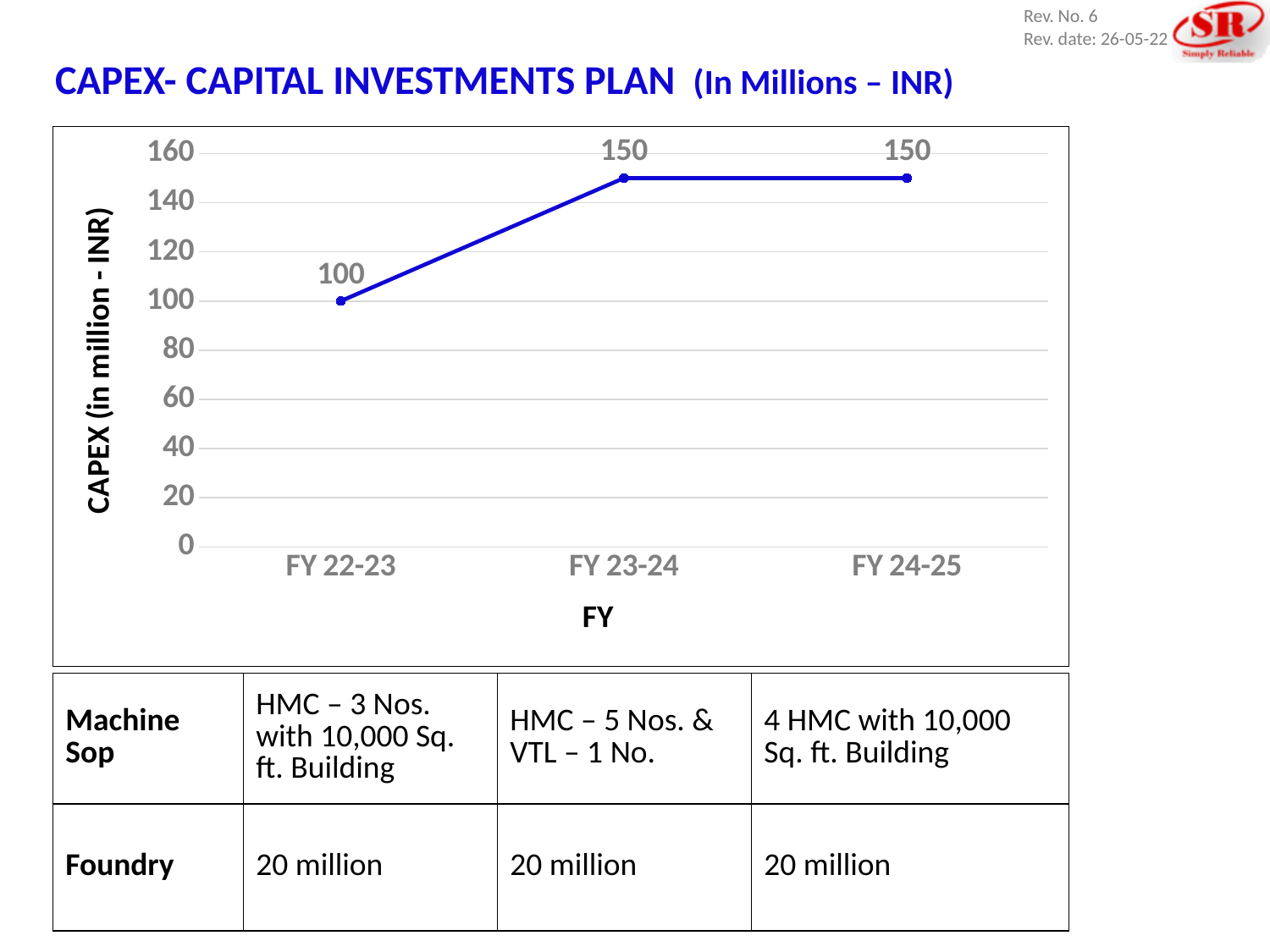
What is the CAPEX value for FY 22-23? 100 Which fiscal year has the lowest CAPEX value? FY 22-23 Does the CAPEX value rise or fall from FY 22-23 to FY 23-24? rise Which is larger, the CAPEX value for FY 22-23 or for FY 23-24? FY 23-24 What is the CAPEX value for FY 23-24? 150 What is the difference between the CAPEX values for FY 23-24 and FY 22-23? 50 How many fiscal years are plotted on the chart? 3 What kind of chart is shown on the slide? line chart What is the label of the vertical axis of the chart? CAPEX (in million - INR) What is the CAPEX value for FY 24-25? 150 Is the CAPEX value for FY 22-23 greater or less than 120? less What is the label of the horizontal axis of the chart? FY